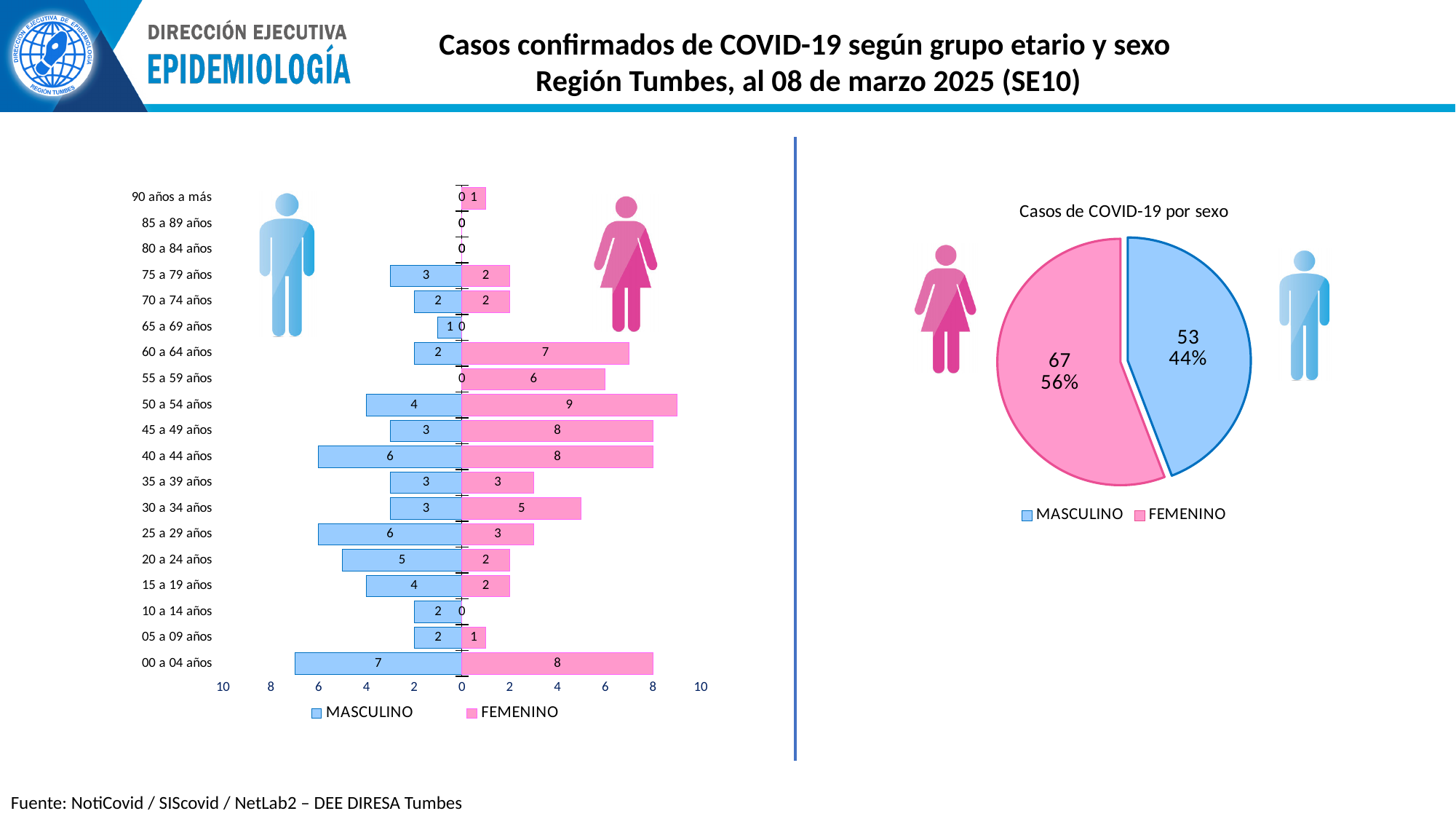
What kind of chart is the left chart? Bar chart In the left chart, which is larger in the 25 a 29 años group, MASCULINO or FEMENINO? MASCULINO In the left chart, how many FEMENINO cases are there in the 50 a 54 años group? 9 How many series does the legend of the pie chart 'Casos de COVID-19 por sexo' list? 2 In the left chart, how many MASCULINO cases are there in the 00 a 04 años group? 7 In the left chart, what is the difference between FEMENINO and MASCULINO cases in the 55 a 59 años group? 6 In the pie chart 'Casos de COVID-19 por sexo', what share of cases is MASCULINO? 44% In the left chart, which age group has the highest number of MASCULINO cases? 00 a 04 años In the left chart, how many FEMENINO cases are there in the 60 a 64 años group? 7 In the left chart, which age group has the highest number of FEMENINO cases? 50 a 54 años In the left chart, how many age groups are listed on the vertical axis? 19 In the pie chart 'Casos de COVID-19 por sexo', how many FEMENINO cases are there? 67